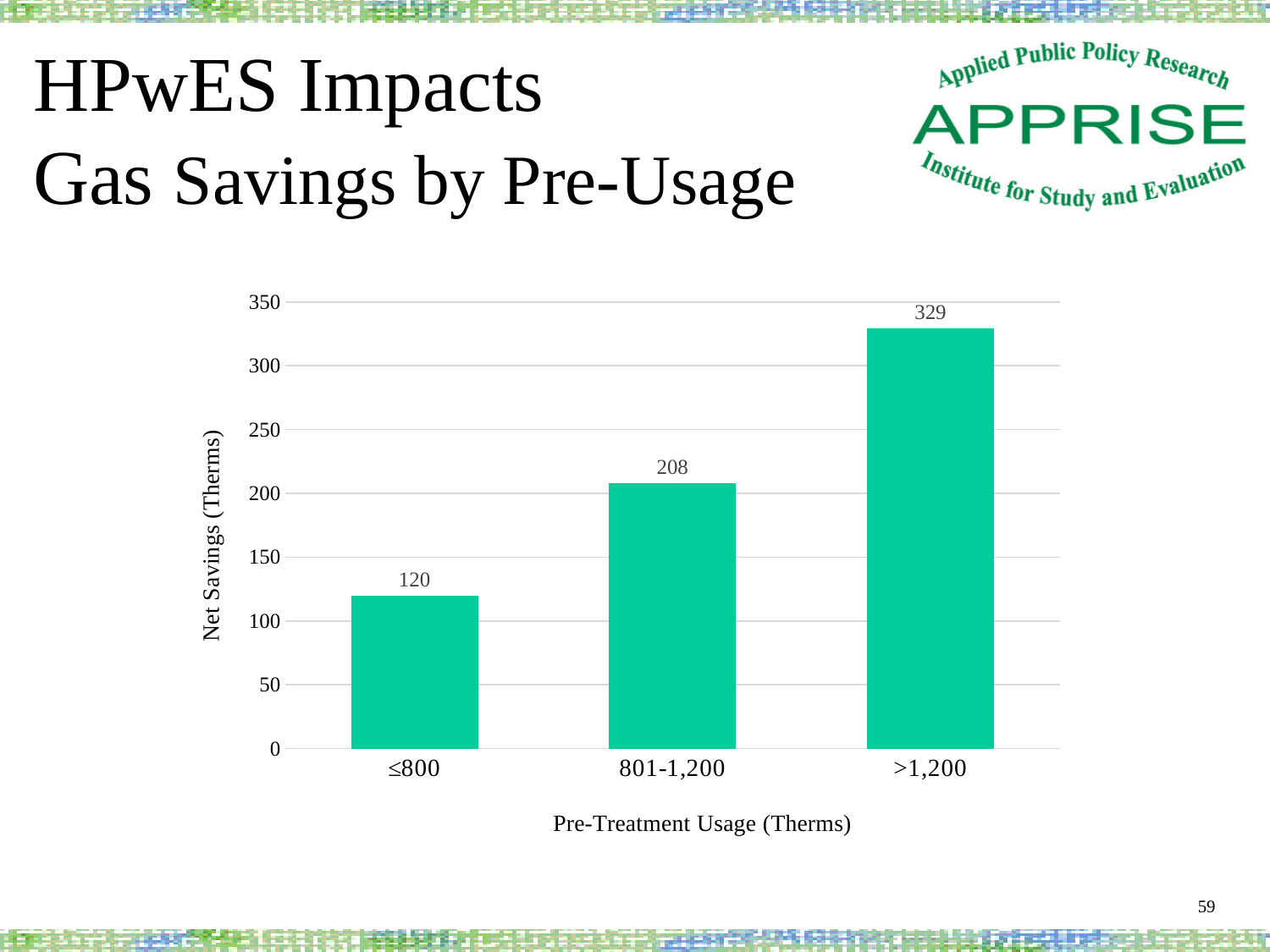
Which pre-treatment usage group has the lowest net savings? ≤800 Do net savings rise or fall as pre-treatment usage increases along the x axis? rise What kind of chart is shown on the slide? bar chart What is the net savings value for the ≤800 pre-treatment usage group? 120 How many pre-treatment usage groups are shown on the chart? 3 What is the net savings value for the >1,200 pre-treatment usage group? 329 What is the difference in net savings between the >1,200 group and the ≤800 group? 209 Is the net savings value for the 801-1,200 group greater or less than 250? less Which pre-treatment usage group has the highest net savings? >1,200 Which group has larger net savings, 801-1,200 or >1,200? >1,200 What is the net savings value for the 801-1,200 pre-treatment usage group? 208 What is the difference in net savings between the 801-1,200 group and the ≤800 group? 88